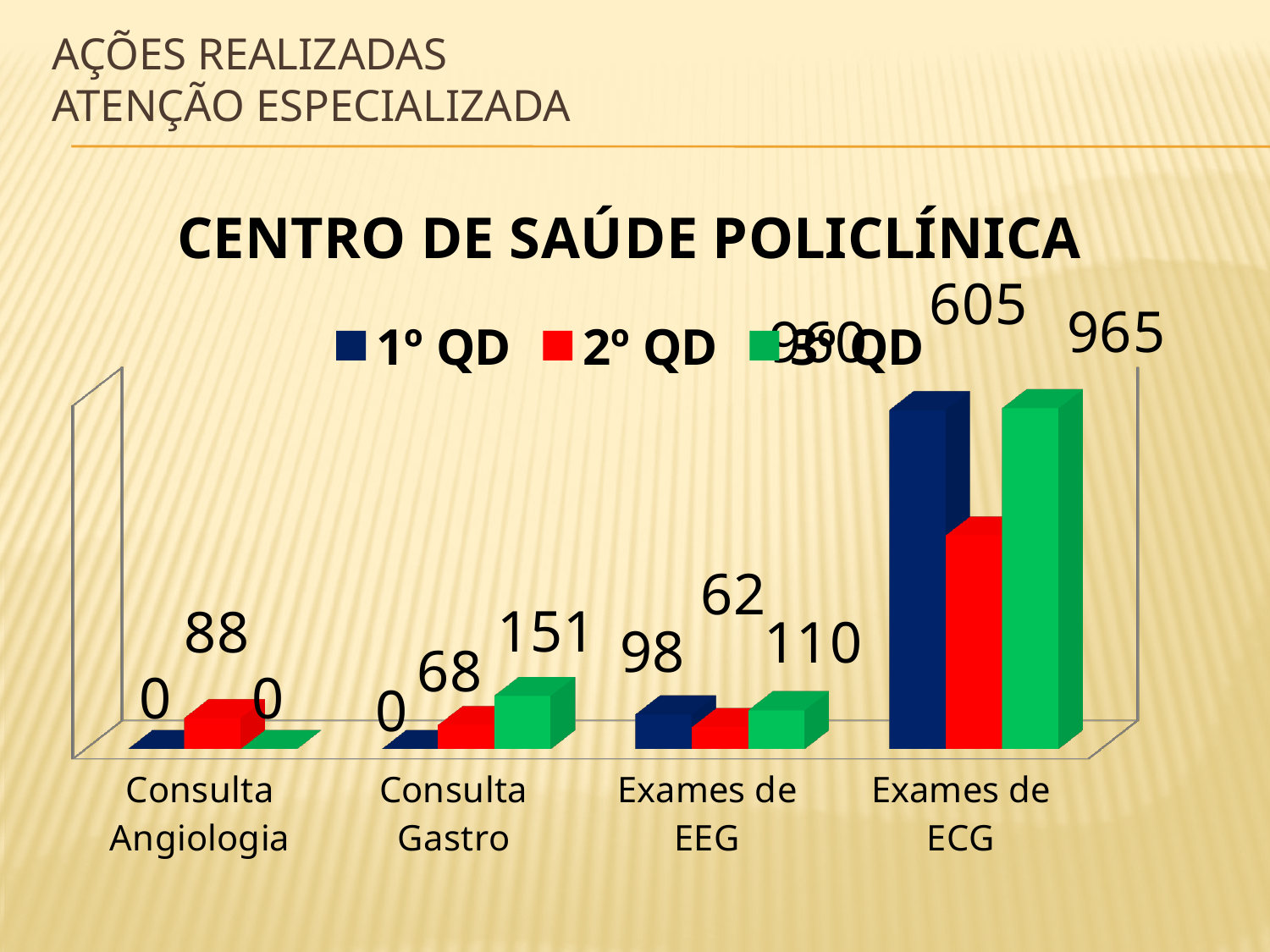
Which is larger for Exames de EEG: the 2º QD value or the 3º QD value? 3º QD What is the difference between the 3º QD and 1º QD values for Exames de ECG? 5 What is the 3º QD value for Exames de ECG? 965 What is the 1º QD value for Exames de EEG? 98 How many series does the legend list? 3 What is the title of the chart? CENTRO DE SAÚDE POLICLÍNICA What is the difference between the 3º QD and 2º QD values for Consulta Gastro? 83 How many categories are shown on the x axis? 4 What is the 3º QD value for Consulta Gastro? 151 What type of chart is shown on the slide? bar chart What is the 2º QD value for Consulta Angiologia? 88 Which category has the highest 1º QD value? Exames de ECG